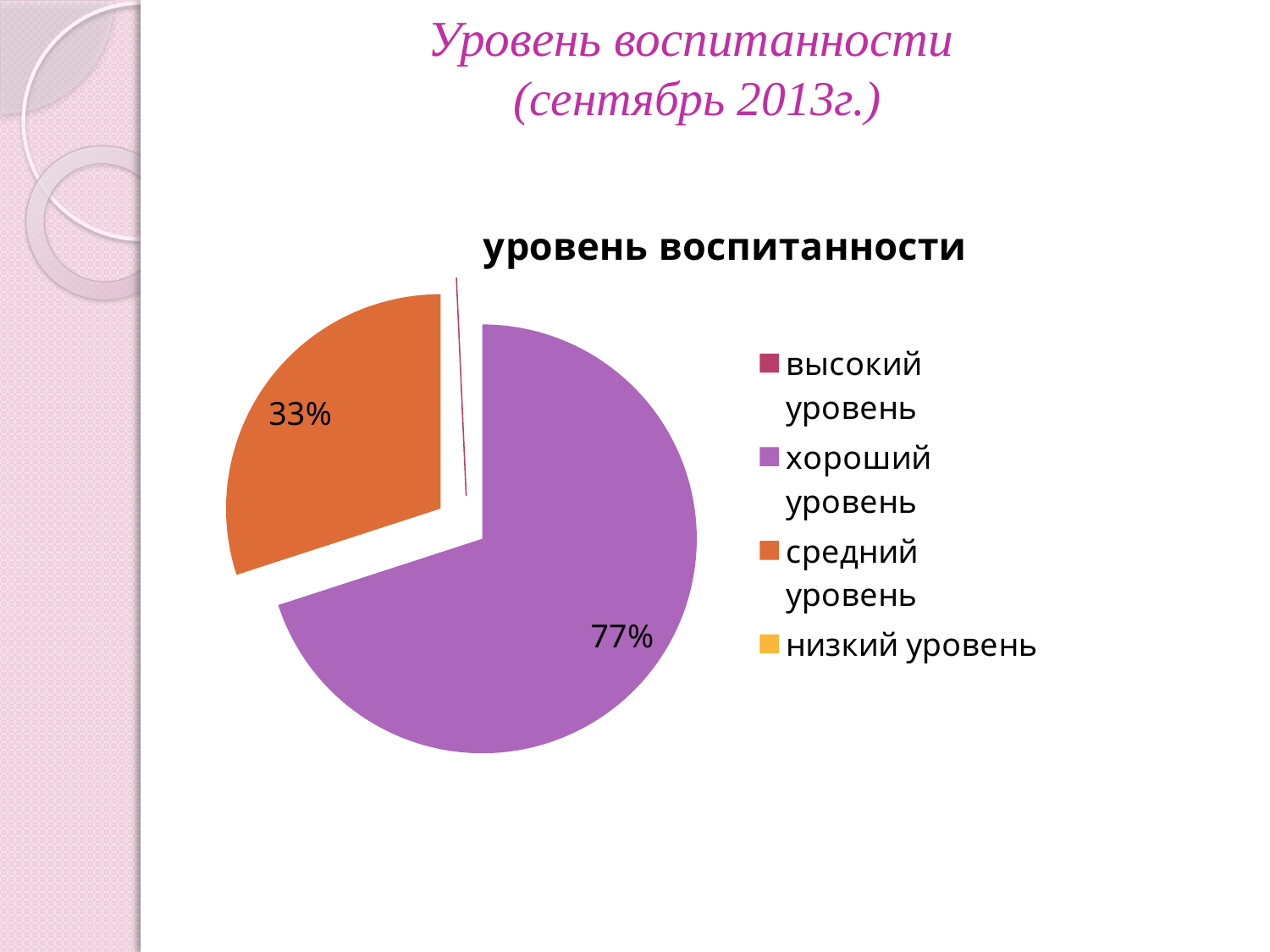
Which colour represents средний уровень in the chart? Orange What kind of chart is shown on the slide? Pie chart What percentage does the хороший уровень slice show? 77% Which legend entry is shown in purple? хороший уровень How many categories does the chart legend list? 4 By how many percentage points does the хороший уровень slice exceed the средний уровень slice? 44 percentage points Is the share for хороший уровень greater or less than 50%? greater Which is larger, the slice for хороший уровень or the slice for средний уровень? хороший уровень What is the title of the chart? уровень воспитанности Which category has the largest slice of the pie? хороший уровень What percentage does the средний уровень slice show? 33%